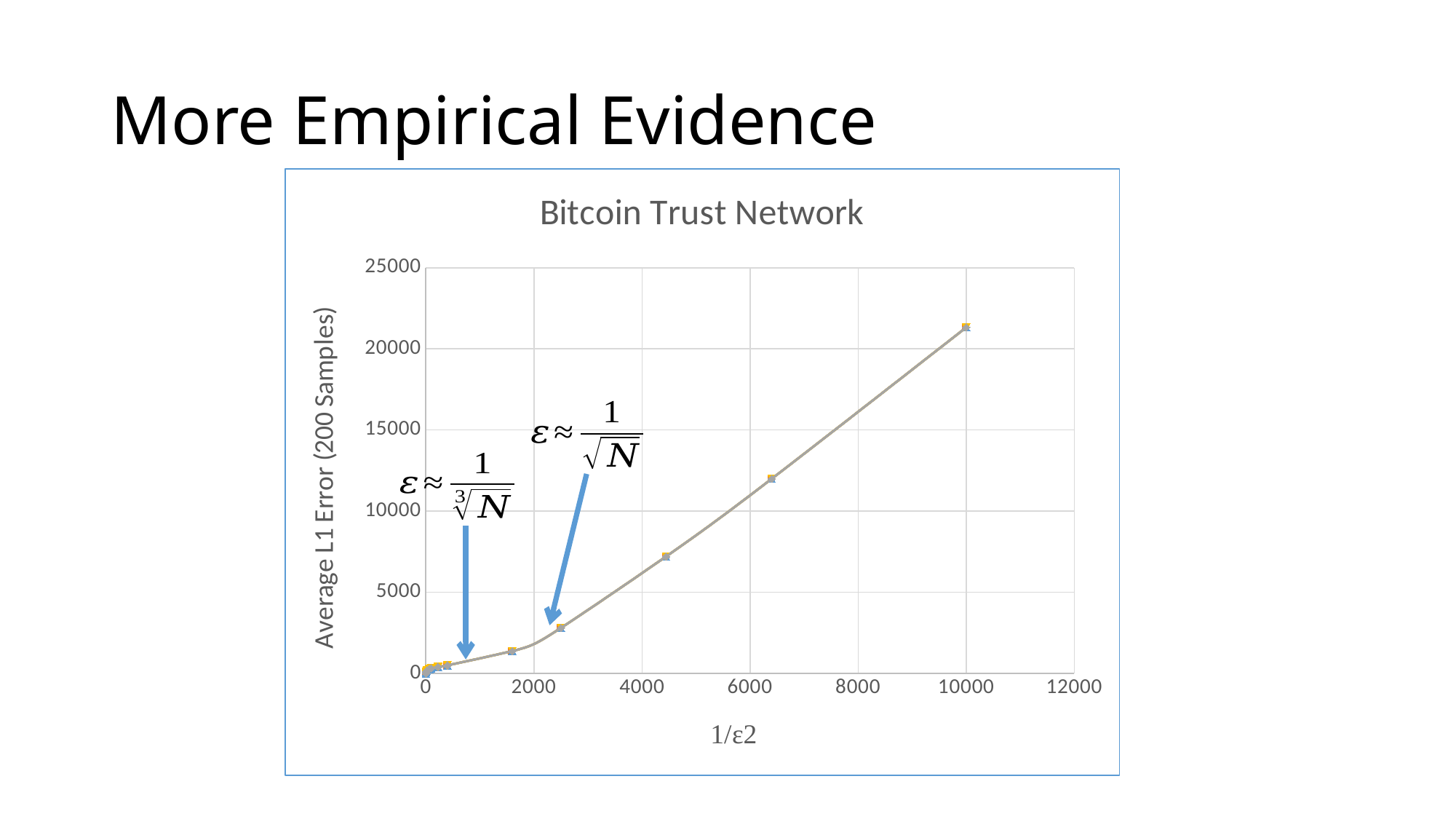
What is the label of the y axis? Average L1 Error (200 Samples) Is the value at 1/ε2 = 2500 greater or less than 5000? less Is the value at 1/ε2 = 6400 greater or less than 15000? less What is the title of the chart? Bitcoin Trust Network Is the value at 1/ε2 = 10000 greater or less than 20000? greater Which has the larger Average L1 Error: 1/ε2 = 6400 or 1/ε2 = 4400? 1/ε2 = 6400 At which plotted value of 1/ε2 is the Average L1 Error highest? 10000 Do the values rise or fall as 1/ε2 increases along the x axis? rise What kind of chart is shown on the slide? line chart